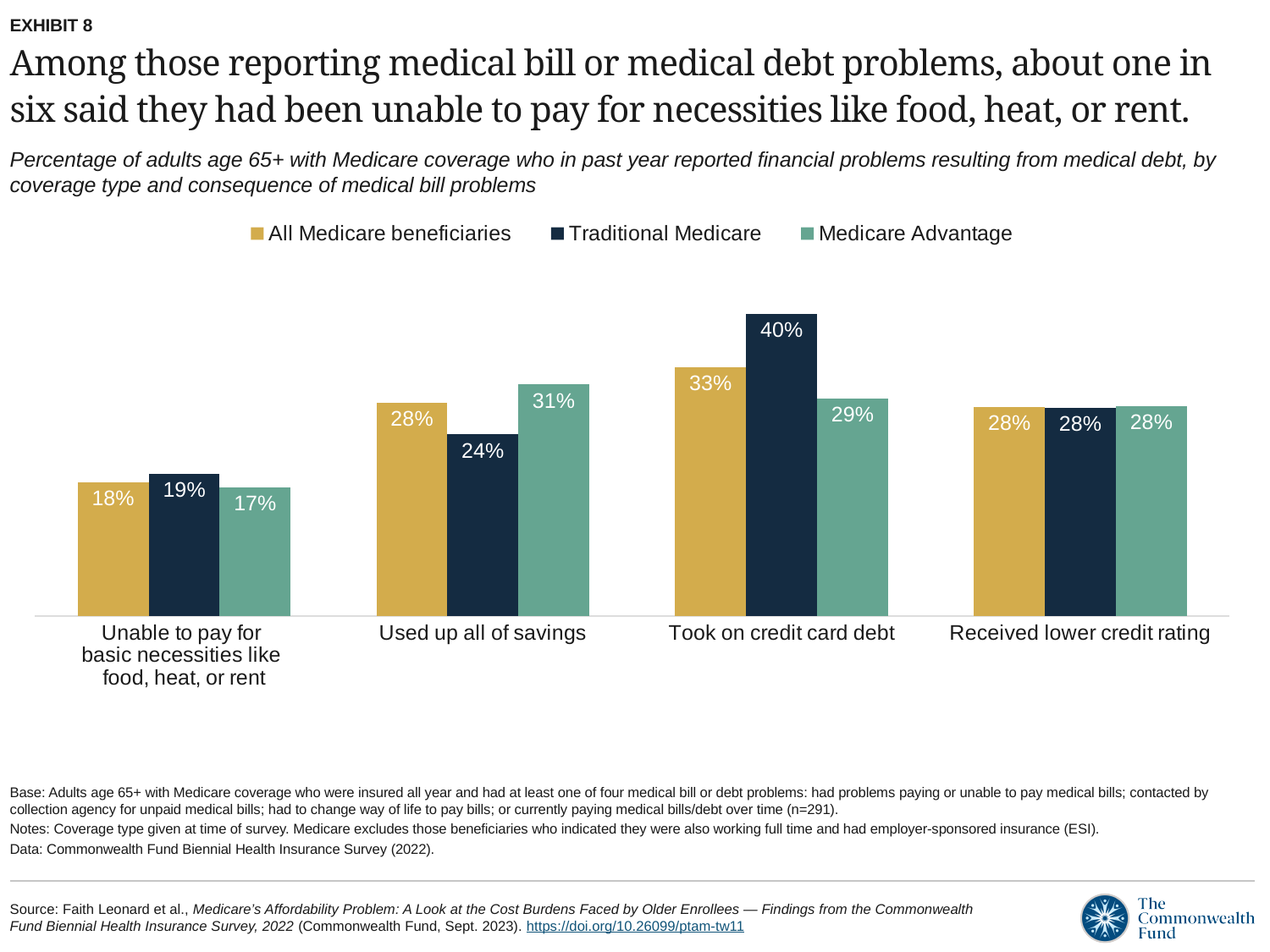
Which series is shown in dark navy blue? Traditional Medicare How many series does the legend list? 3 Which category has the lowest value for Medicare Advantage? Unable to pay for basic necessities like food, heat, or rent What is the difference between Traditional Medicare and Medicare Advantage for 'Took on credit card debt'? 11 percentage points How many categories are shown on the x axis? 4 For 'Used up all of savings', which is larger: Traditional Medicare or Medicare Advantage? Medicare Advantage In which category do all three series have the same value? Received lower credit rating What is the value for Medicare Advantage in the 'Used up all of savings' category? 31% Which category has the highest value for Traditional Medicare? Took on credit card debt What kind of chart is shown on the slide? Bar chart What percentage of Traditional Medicare beneficiaries took on credit card debt? 40% What percentage of all Medicare beneficiaries were unable to pay for basic necessities like food, heat, or rent? 18%